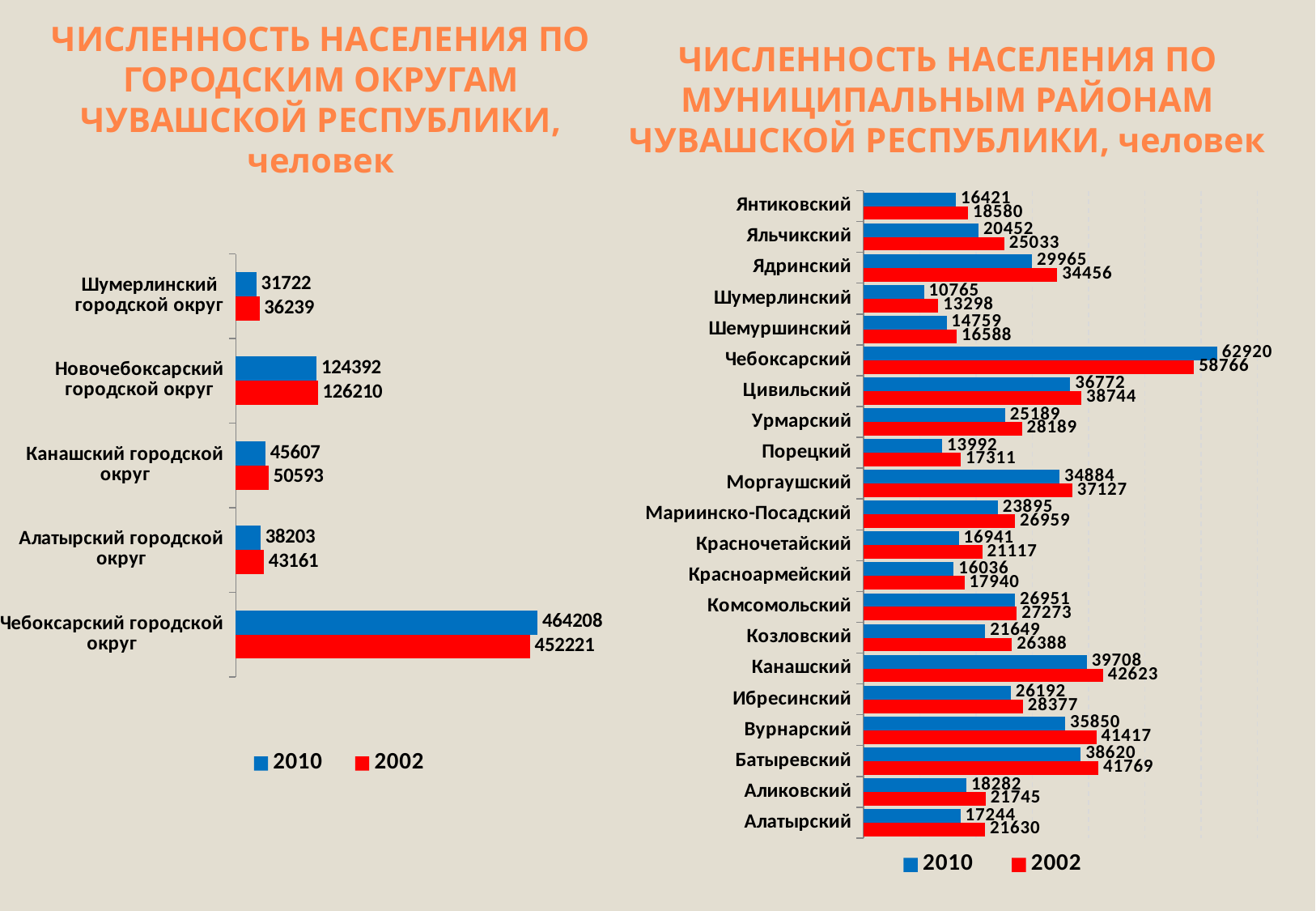
In the right chart (Численность населения по муниципальным районам), what is the difference between the 2002 and 2010 values for Ядринский? 4491 In the left chart (Численность населения по городским округам), by how much did the population of Чебоксарский городской округ change from 2002 to 2010? 11987 In the left chart (Численность населения по городским округам), how many urban districts are shown? 5 In the left chart (Численность населения по городским округам), which urban district has the highest 2010 population? Чебоксарский городской округ In the right chart (Численность населения по муниципальным районам), which district has the lowest 2010 population? Шумерлинский In the left chart (Численность населения по городским округам), what is the 2010 value for Новочебоксарский городской округ? 124392 In the right chart (Численность населения по муниципальным районам), what is the 2002 value for Канашский? 42623 In the right chart (Численность населения по муниципальным районам), which had the larger 2010 population, Вурнарский or Батыревский? Батыревский In the right chart (Численность населения по муниципальным районам), how many municipal districts are shown? 21 In the right chart (Численность населения по муниципальным районам), how many series does the legend list? 2 In the right chart (Численность населения по муниципальным районам), which district has the highest 2010 population? Чебоксарский What type of chart is the left chart (Численность населения по городским округам)? Bar chart